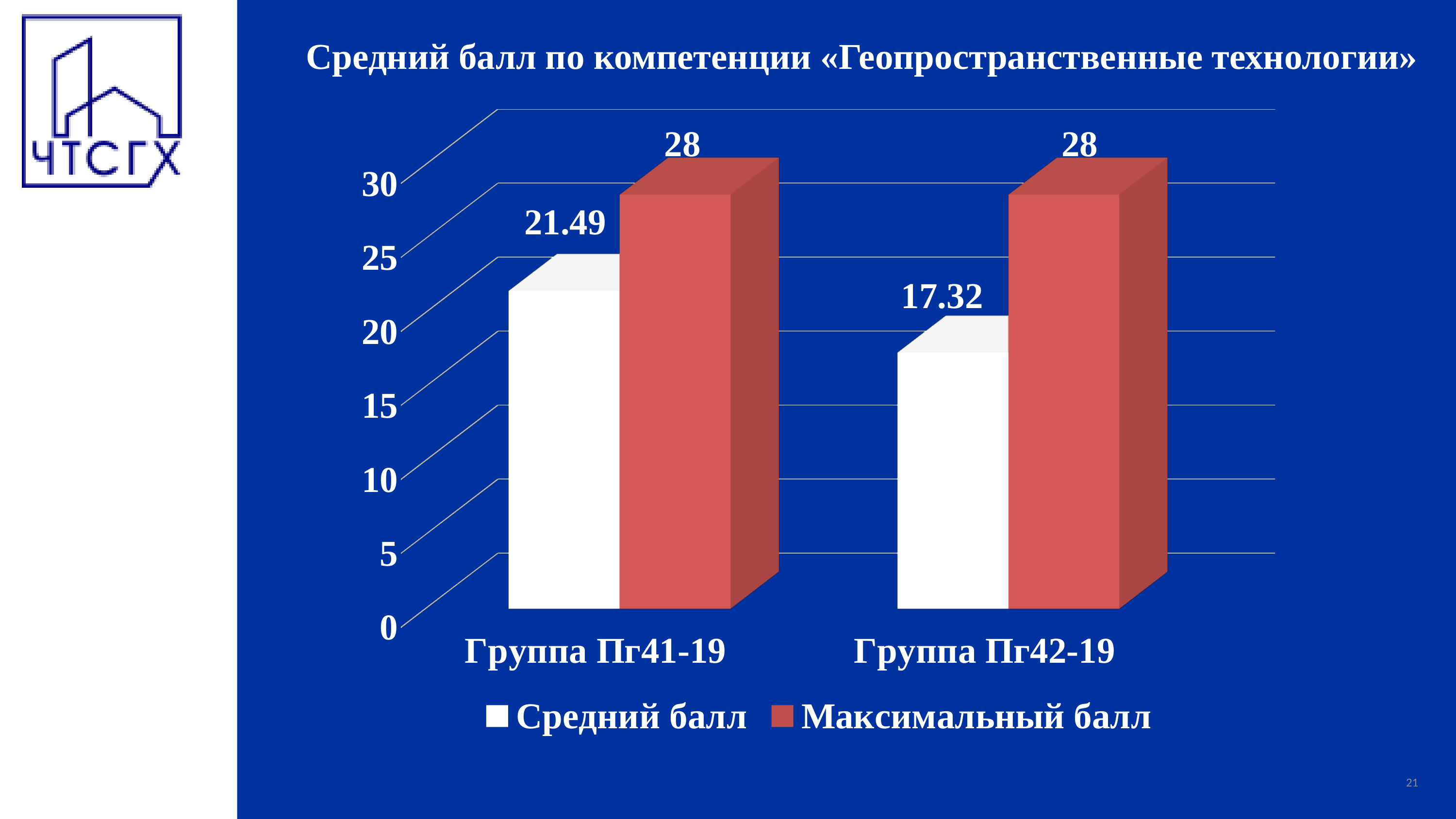
What is the Максимальный балл for Группа Пг41-19? 28 Which colour represents Максимальный балл in the legend? red What is the Средний балл for Группа Пг41-19? 21.49 Which group has the lower Средний балл? Группа Пг42-19 What is the difference between the Средний балл of Группа Пг41-19 and Группа Пг42-19? 4.17 Is the Средний балл for Группа Пг42-19 greater or less than 20? less How many groups are shown on the x axis? 2 Which group has the higher Средний балл? Группа Пг41-19 How many series does the legend list? 2 What kind of chart is shown on the slide? bar chart What is the Средний балл for Группа Пг42-19? 17.32 What is the difference between the Максимальный балл and the Средний балл for Группа Пг42-19? 10.68